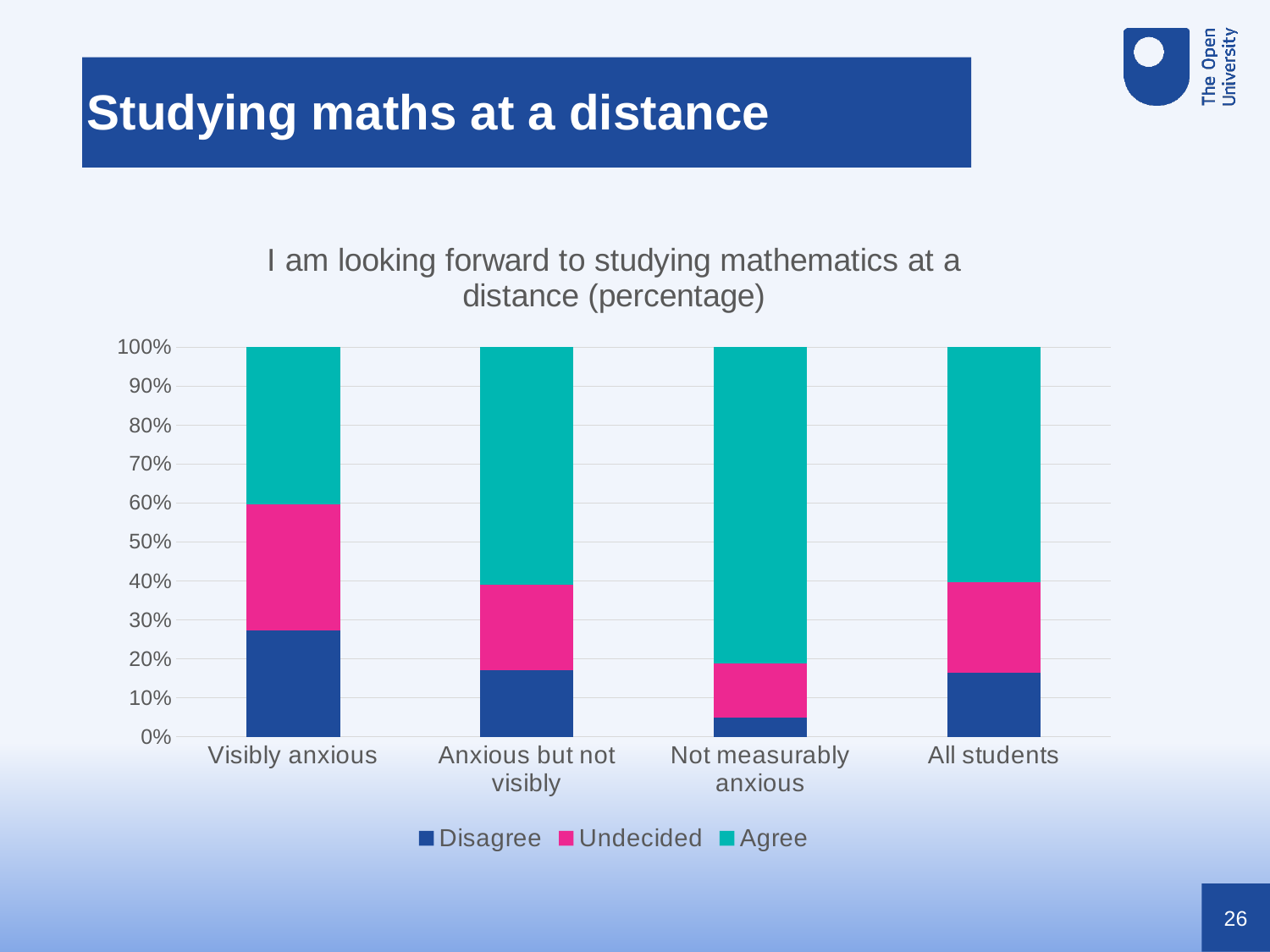
What is the total height of the stacked bar for All students? 100% What is the title of the chart? I am looking forward to studying mathematics at a distance (percentage) Which category has the largest Disagree segment? Visibly anxious Which category has the smallest Disagree segment? Not measurably anxious Which series is shown in dark blue in the chart? Disagree Is the Disagree value for Not measurably anxious greater or less than 10%? less Is the Disagree value for Visibly anxious greater or less than 20%? greater Which category has the largest Agree segment? Not measurably anxious How many series does the chart's legend list? 3 What kind of chart is shown on the slide? Stacked bar chart How many categories are shown along the x axis of the chart? 4 Is the Undecided segment larger for Visibly anxious or for Not measurably anxious? Visibly anxious